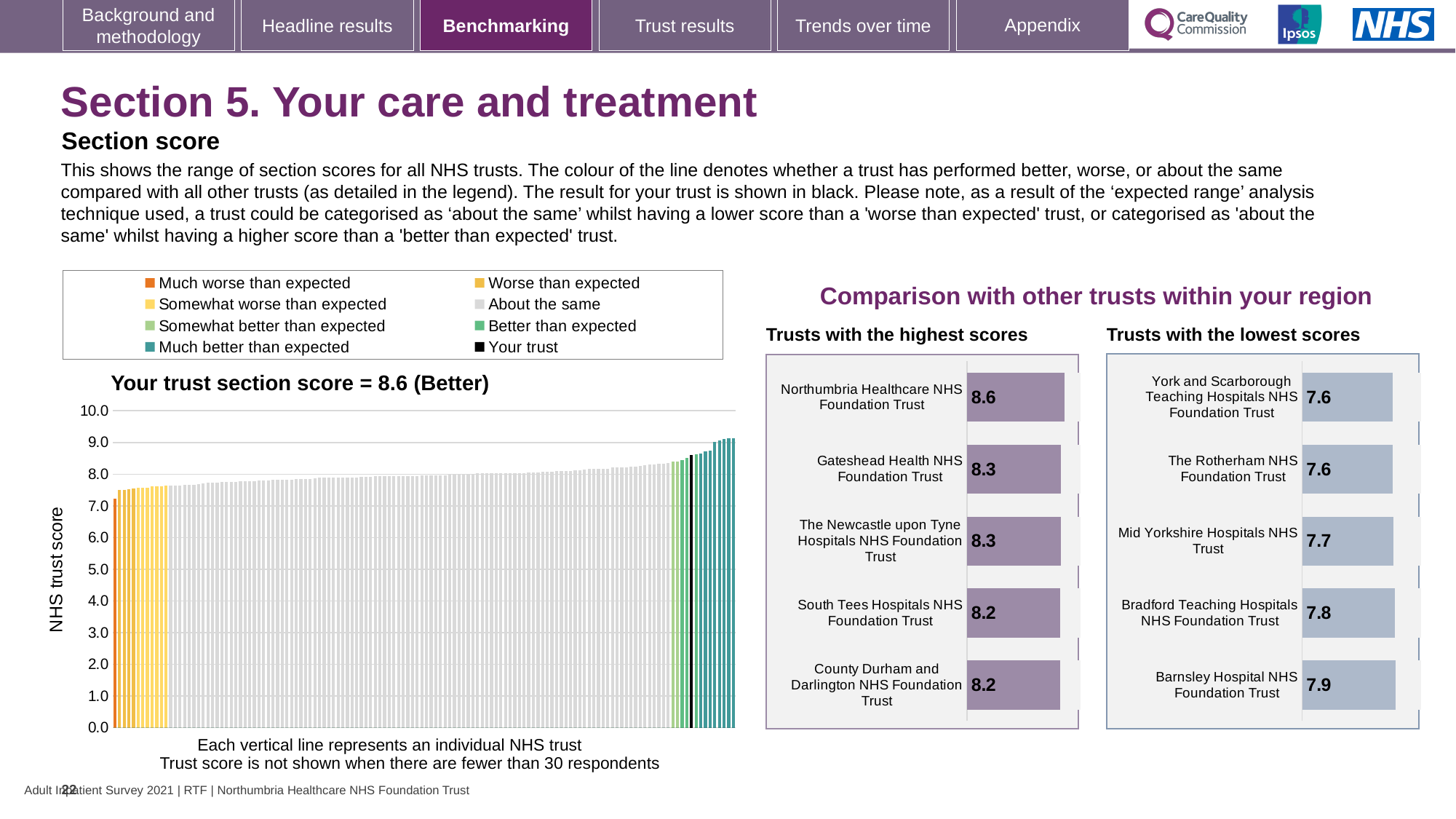
In the 'Your trust section score' chart, is the value of the lowest-scoring trust greater or less than 6.0? greater In the 'Trusts with the highest scores' chart, what is the difference between the scores of Northumbria Healthcare NHS Foundation Trust and South Tees Hospitals NHS Foundation Trust? 0.4 In the 'Your trust section score' chart, how many entries does the legend list? 8 In the 'Trusts with the highest scores' chart, what is the score for Gateshead Health NHS Foundation Trust? 8.3 In the 'Your trust section score' chart, what is the label on the vertical axis? NHS trust score In the 'Trusts with the highest scores' chart, how many trusts are shown? 5 In the 'Your trust section score' chart, do the trust scores rise or fall from left to right? Rise What kind of chart is the 'Your trust section score' chart? Bar chart In the 'Trusts with the lowest scores' chart, which has the higher score: Bradford Teaching Hospitals NHS Foundation Trust or The Rotherham NHS Foundation Trust? Bradford Teaching Hospitals NHS Foundation Trust In the 'Your trust section score' chart, what is the section score for your trust? 8.6 In the 'Trusts with the lowest scores' chart, what is the score for Mid Yorkshire Hospitals NHS Trust? 7.7 In the 'Trusts with the highest scores' chart, which trust has the highest score? Northumbria Healthcare NHS Foundation Trust